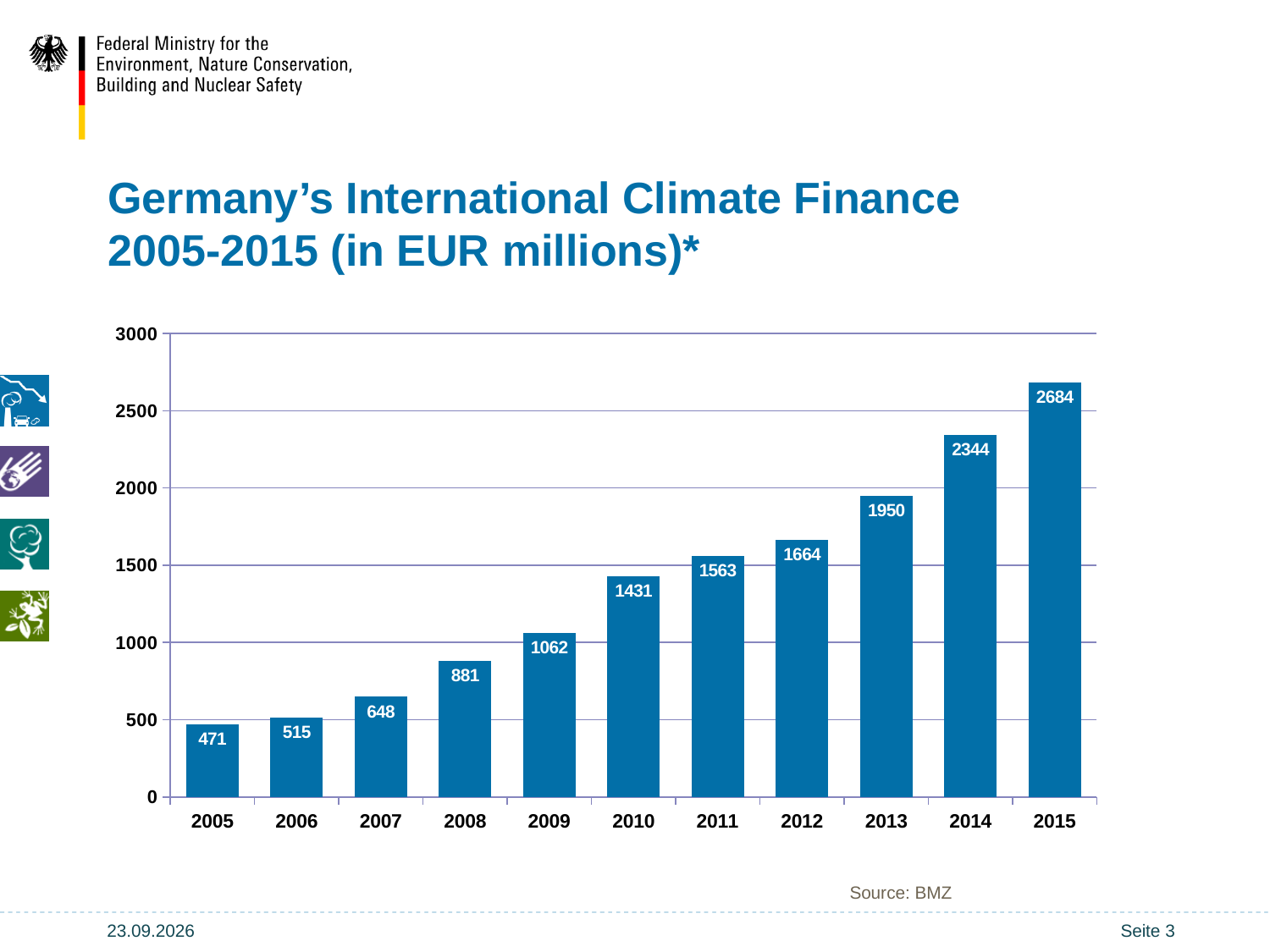
What is the value for 2013? 1950 Which year has the highest value? 2015 Is the value for 2007 greater or less than 500? greater How many years are shown on the x axis? 11 What is the value for 2005? 471 What is the value for 2010? 1431 Which year has the lowest value? 2005 Which is larger, the value for 2011 or the value for 2012? 2012 What kind of chart is shown on the slide? bar chart Do the values rise or fall from 2005 to 2015? rise What is the difference between the values for 2015 and 2014? 340 What is the difference between the values for 2009 and 2008? 181